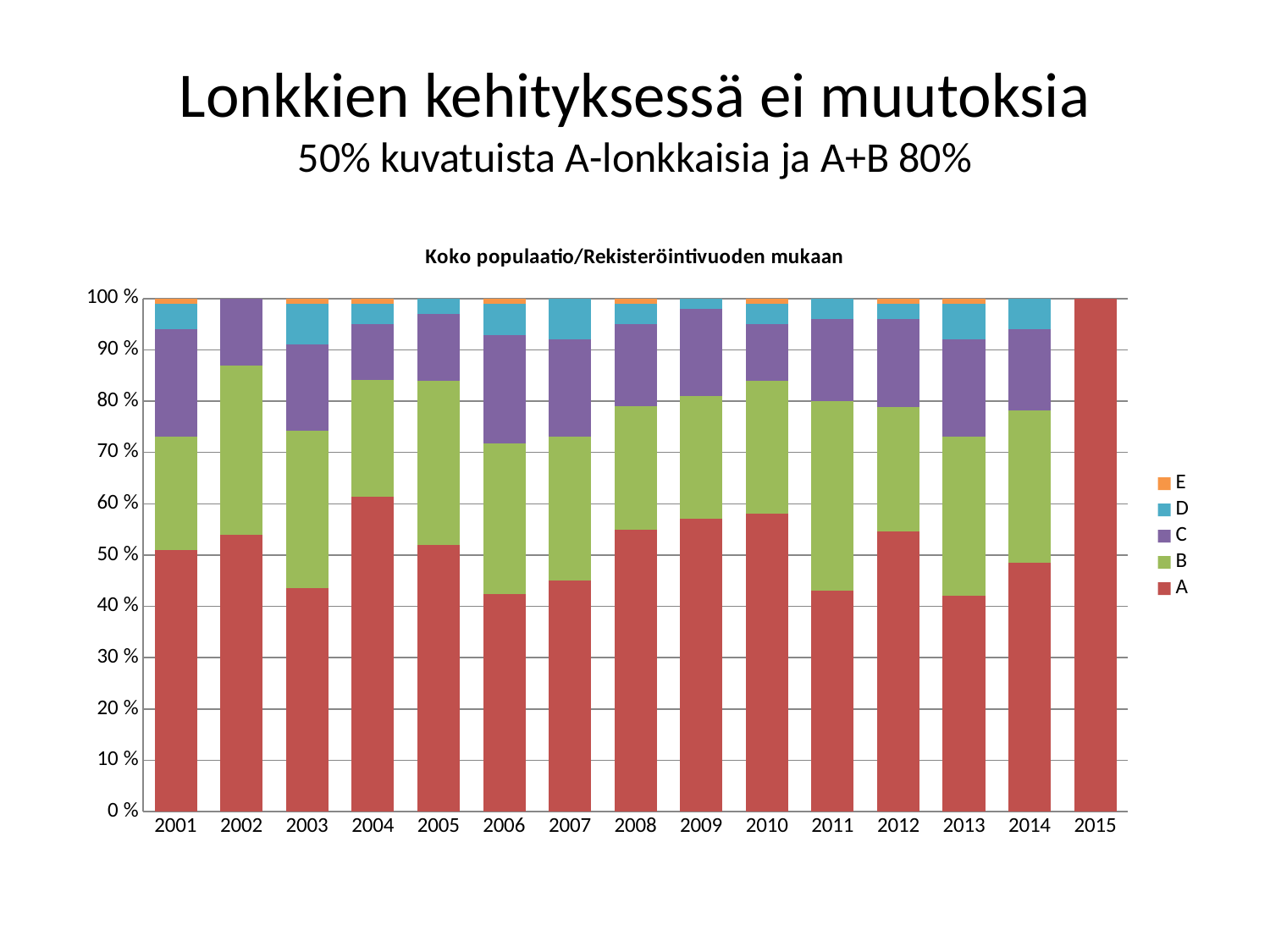
Which is larger, the share of series A in 2010 or in 2003? 2010 How many years are shown on the x axis? 15 How many series does the legend list? 5 What is the title of the chart? Koko populaatio/Rekisteröintivuoden mukaan Which is larger, the share of series A in 2004 or in 2013? 2004 Which colour represents series A in the chart? red Is the value for series A in 2013 greater or less than 50 %? less What kind of chart is shown on the slide? bar chart Is the value for series A in 2006 greater or less than 50 %? less Is the value for series A in 2004 greater or less than 50 %? greater In which year is the share of series A highest? 2015 What is the value for series A in 2015? 100 %